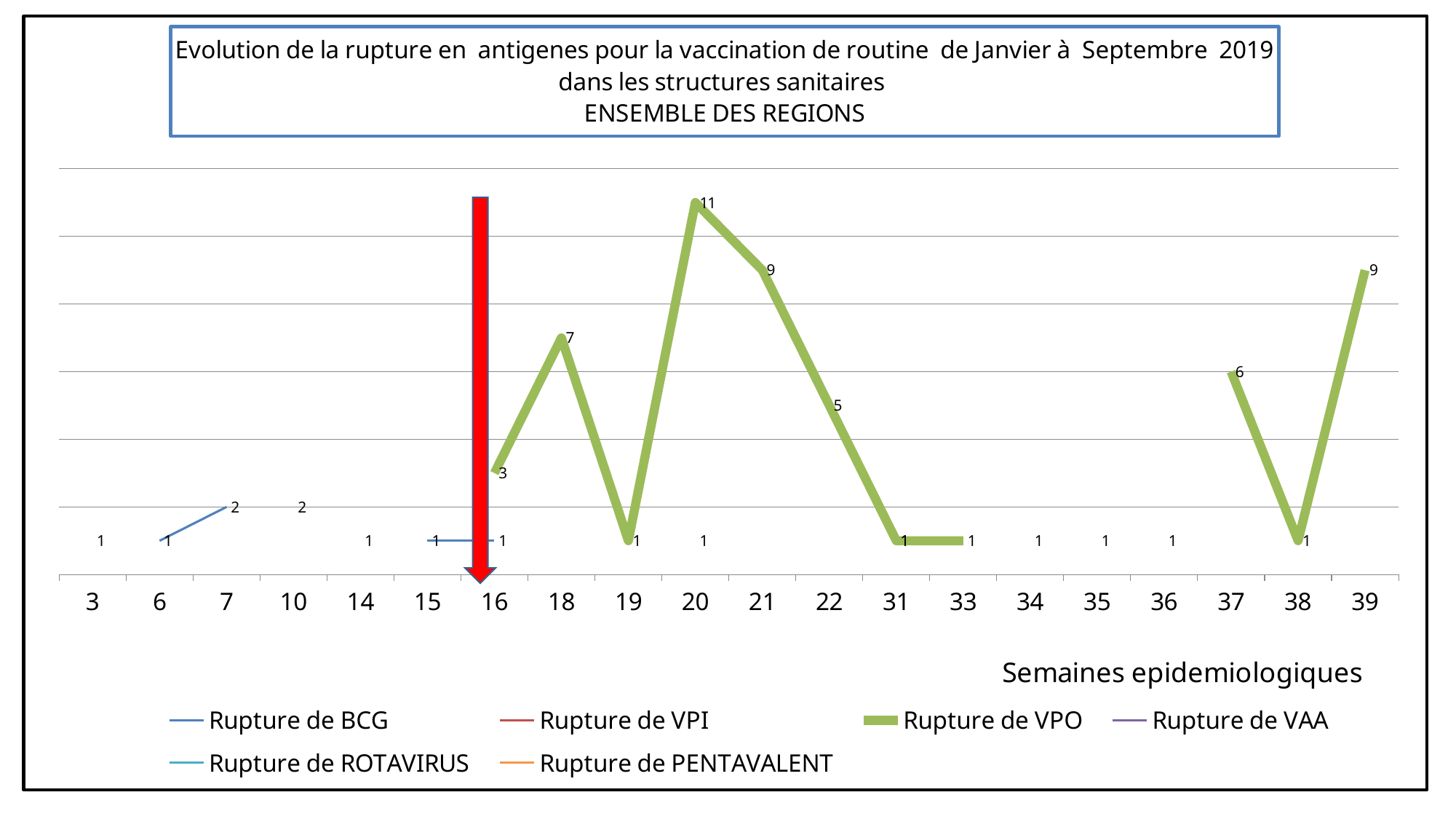
What is the value of Rupture de VPO at week 18? 7 At which week does Rupture de VPO reach its highest value? 20 Which is larger for Rupture de VPO: the value at week 18 or at week 22? week 18 Does Rupture de VPO rise or fall from week 20 to week 31? fall How many series does the legend list? 6 What is the difference between the Rupture de VPO values at week 39 and week 38? 8 What is the value of Rupture de VPO at week 39? 9 What kind of chart is this? line chart What is the value of Rupture de VPO at week 20? 11 How many weeks are shown on the x axis? 20 What is the difference between the Rupture de VPO values at week 20 and week 21? 2 What is the value of Rupture de BCG at week 7? 2